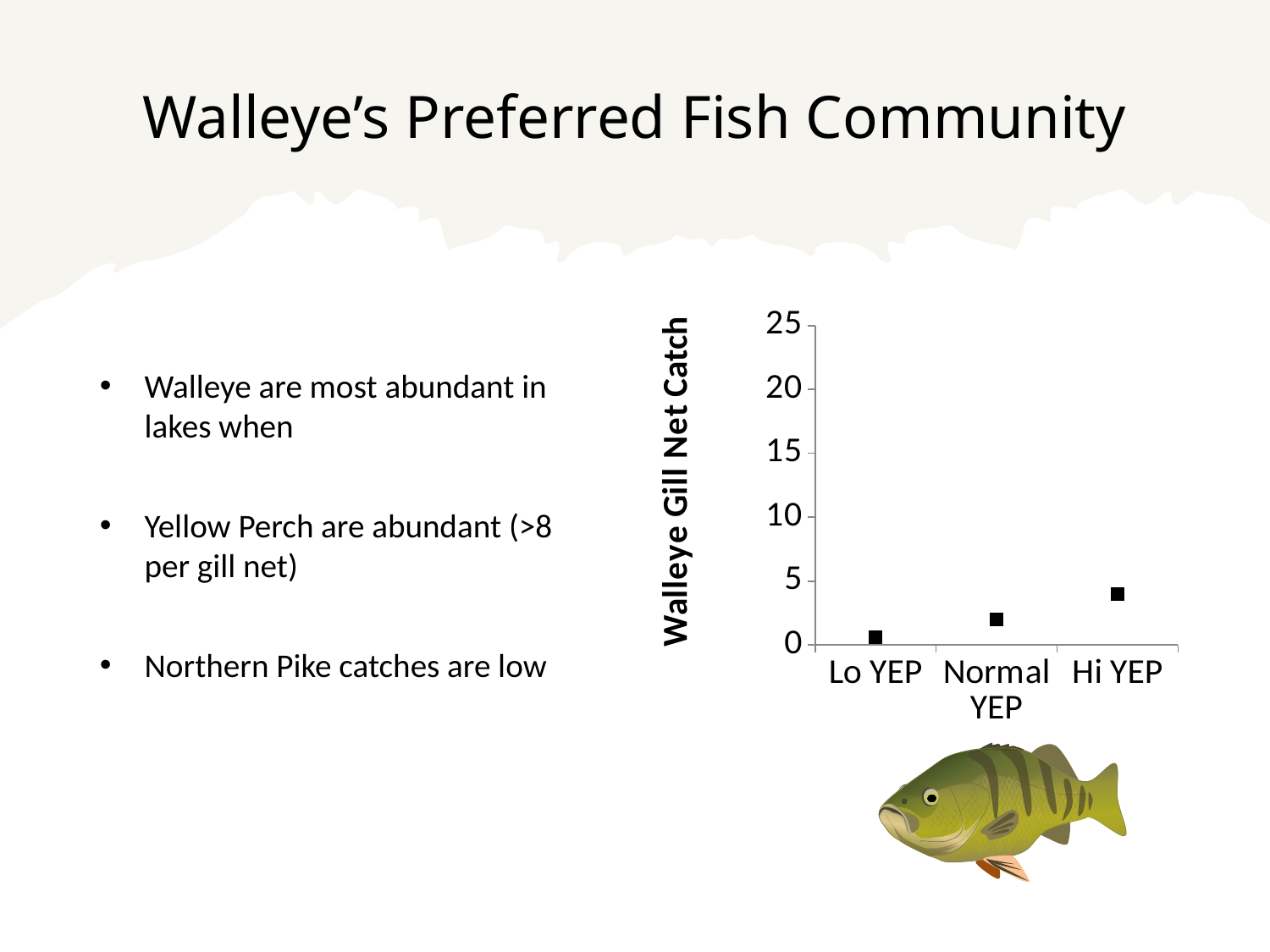
Which category has the highest Walleye Gill Net Catch? Hi YEP Is the value for Normal YEP greater or less than 10? less Do the values rise or fall moving from Lo YEP to Hi YEP along the x axis? rise How many categories are shown on the x axis of the chart? 3 Which category has the lowest Walleye Gill Net Catch? Lo YEP Which is larger, the value for Normal YEP or the value for Hi YEP? Hi YEP What is the label of the vertical axis of the chart? Walleye Gill Net Catch What kind of chart is shown on the slide? scatter chart What is the highest tick value shown on the vertical axis? 25 Which is larger, the value for Hi YEP or the value for Lo YEP? Hi YEP Is the value for Lo YEP greater or less than 5? less Is the value for Hi YEP greater or less than 5? less